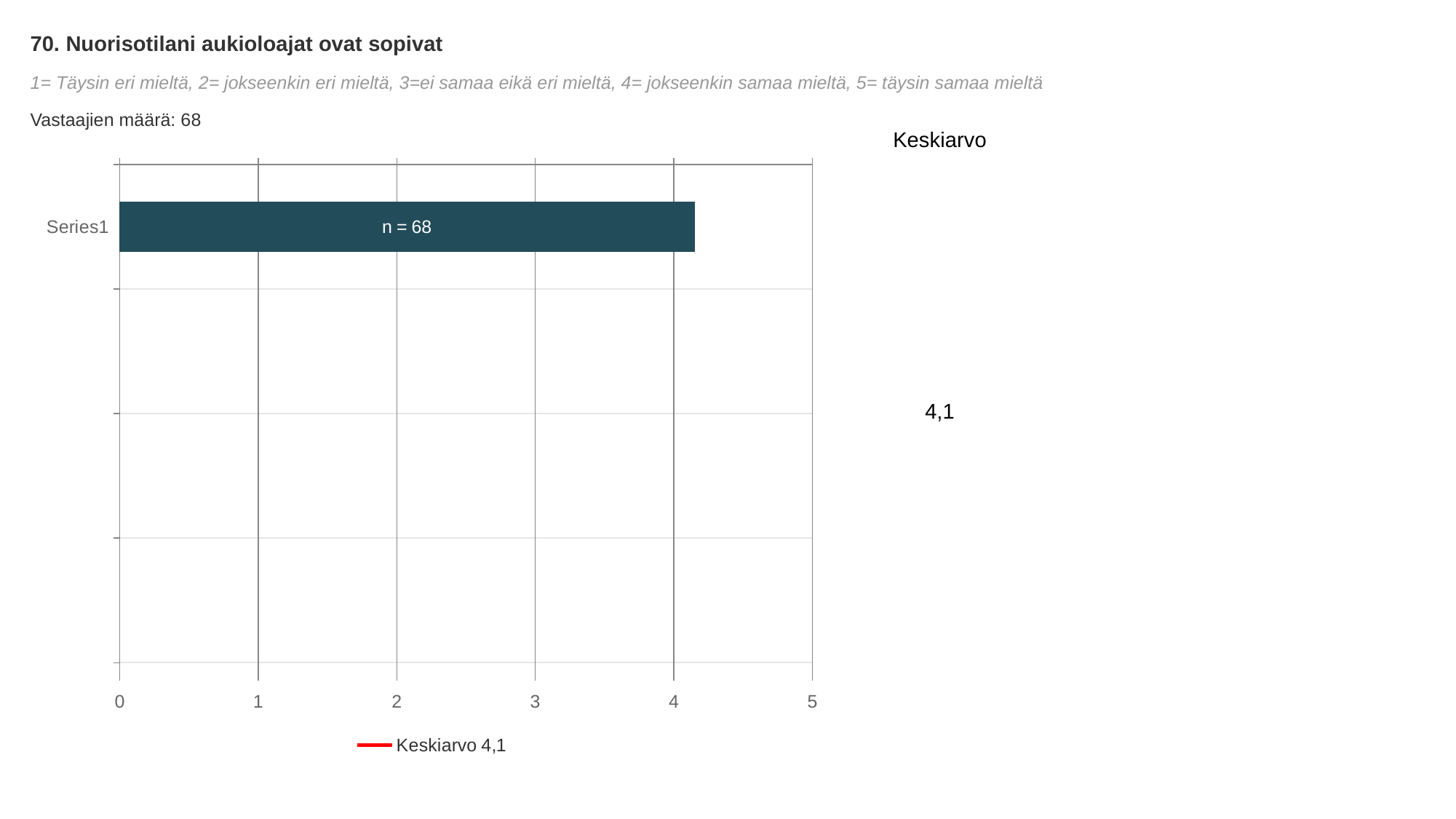
How many respondents (Vastaajien määrä) are reported on the slide? 68 Is the value for Series1 greater or less than 5? less What is the Keskiarvo (mean) value shown on the slide? 4,1 What data label is printed on the Series1 bar? n = 68 What does the legend entry below the chart say? Keskiarvo 4,1 What is the label of the category on the y axis? Series1 What kind of chart is shown on the slide? bar chart What is the highest value shown on the x axis? 5 How many bars are plotted in the chart? 1 Is the value for Series1 greater or less than 3? greater